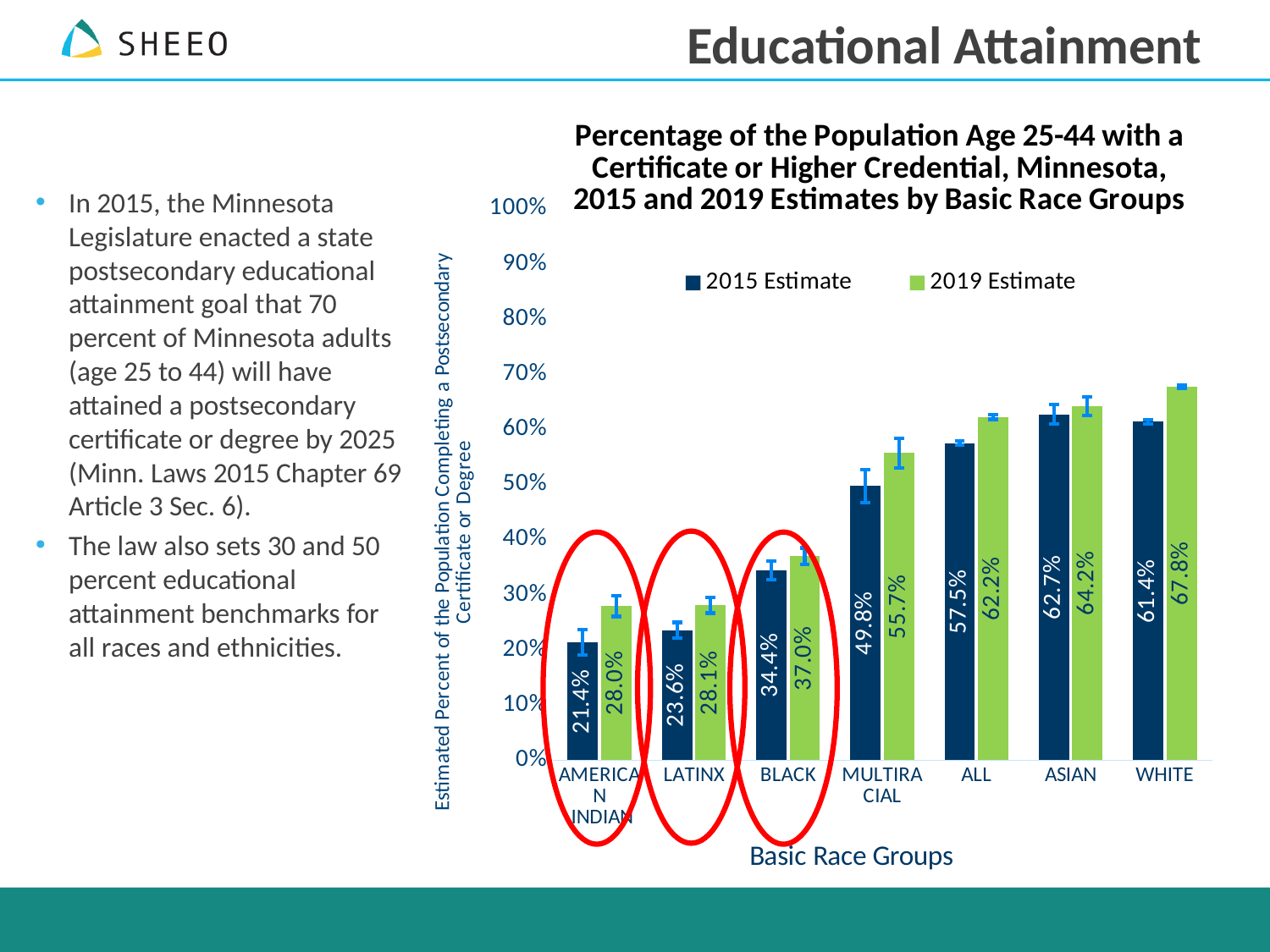
What is the difference between the 2019 Estimate and the 2015 Estimate for White? 6.4% What kind of chart is shown on the slide? Bar chart Which race group has the lowest 2015 Estimate? American Indian Which race group has the highest 2019 Estimate? White How many race groups are shown on the x axis? 7 Which is larger, the 2015 Estimate for Asian or the 2015 Estimate for White? 2015 Estimate for Asian What is the label of the x axis? Basic Race Groups What is the 2019 Estimate value for Black? 37.0% What is the 2015 Estimate value for Asian? 62.7% How many series does the legend list? 2 Is the 2019 Estimate for All greater or less than 60%? greater What is the 2019 Estimate value for Multiracial? 55.7%